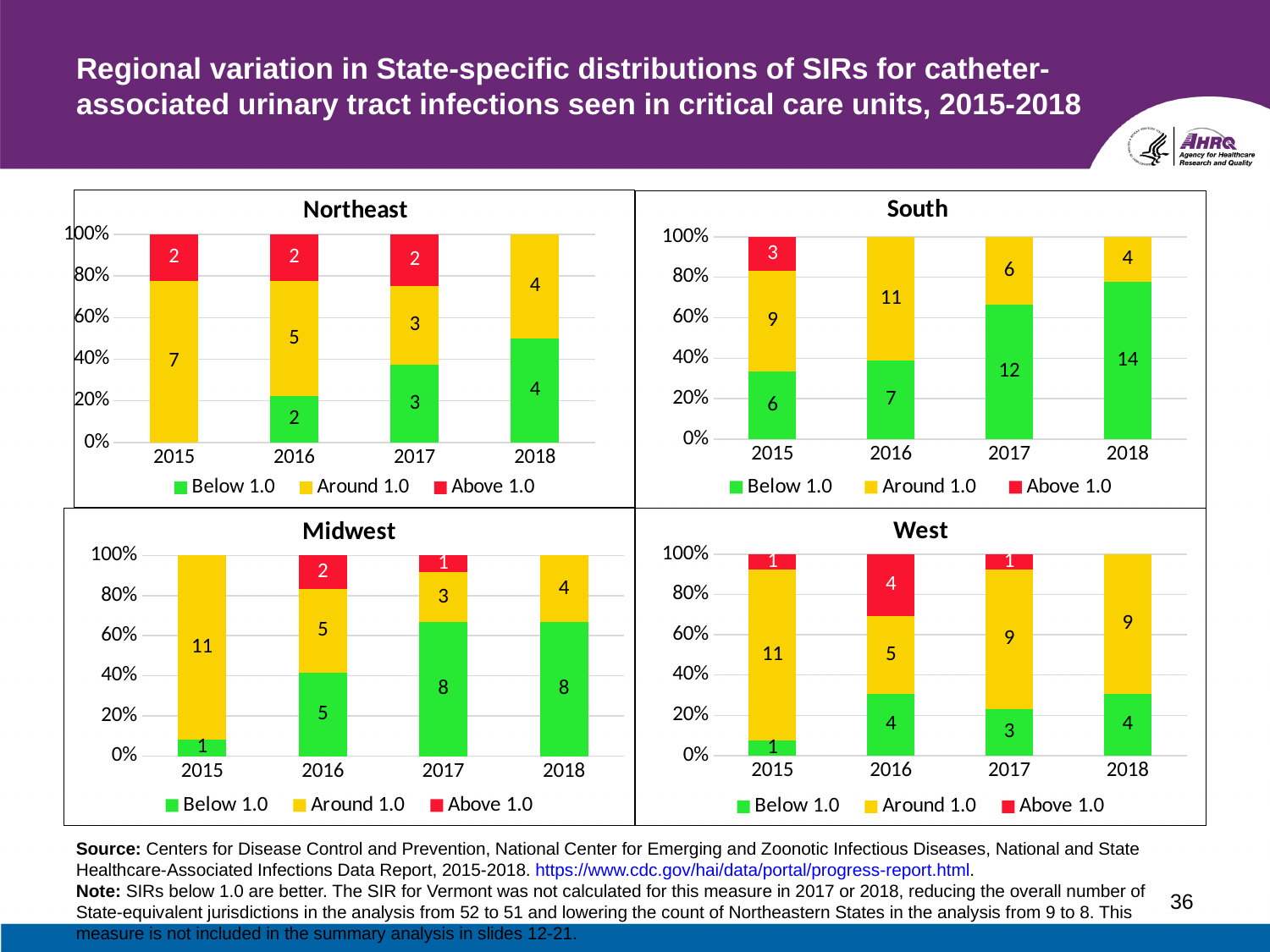
How many series does the legend of the Midwest chart list? 3 In the Midwest chart, which year has the lowest Below 1.0 value? 2015 In the Northeast chart, what is the total number of States represented in the 2016 bar? 9 In the Midwest chart, what is the Around 1.0 value for 2015? 11 In the South chart, what is the Below 1.0 value for 2018? 14 In the West chart, which is larger, the Around 1.0 value for 2015 or for 2016? 2015 In the South chart, what is the total number of States represented in the 2017 bar? 18 In the Northeast chart, how many States were in the Around 1.0 category in 2015? 7 In the South chart, what is the difference between the Below 1.0 values for 2018 and 2015? 8 What type of chart is the West chart? Stacked bar chart In the South chart, which year has the highest Below 1.0 value? 2018 In the West chart, what is the Above 1.0 value for 2016? 4